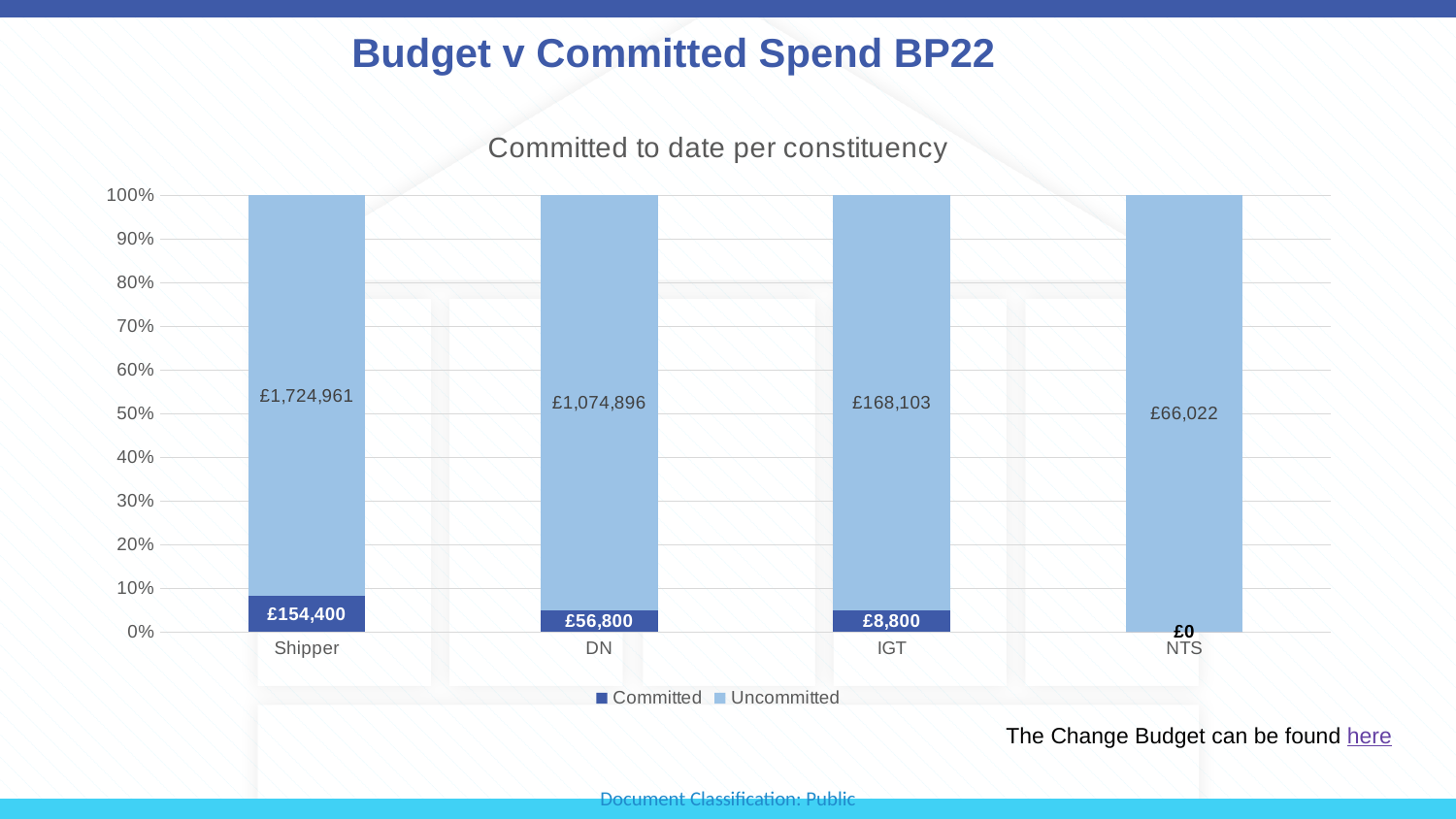
How many constituencies are shown on the x axis? 4 What is the total of the Committed and Uncommitted values for IGT? £176,903 What is the difference between the Committed values for Shipper and DN? £97,600 What kind of chart is shown? Stacked bar chart Which is larger, the Uncommitted value for DN or the Uncommitted value for IGT? DN Which constituency has the highest Committed value? Shipper What is the Committed value for Shipper? £154,400 What is the Committed value for NTS? £0 What is the Uncommitted value for DN? £1,074,896 Which constituency has the lowest Uncommitted value? NTS How many series does the legend list? 2 What is the Uncommitted value for IGT? £168,103